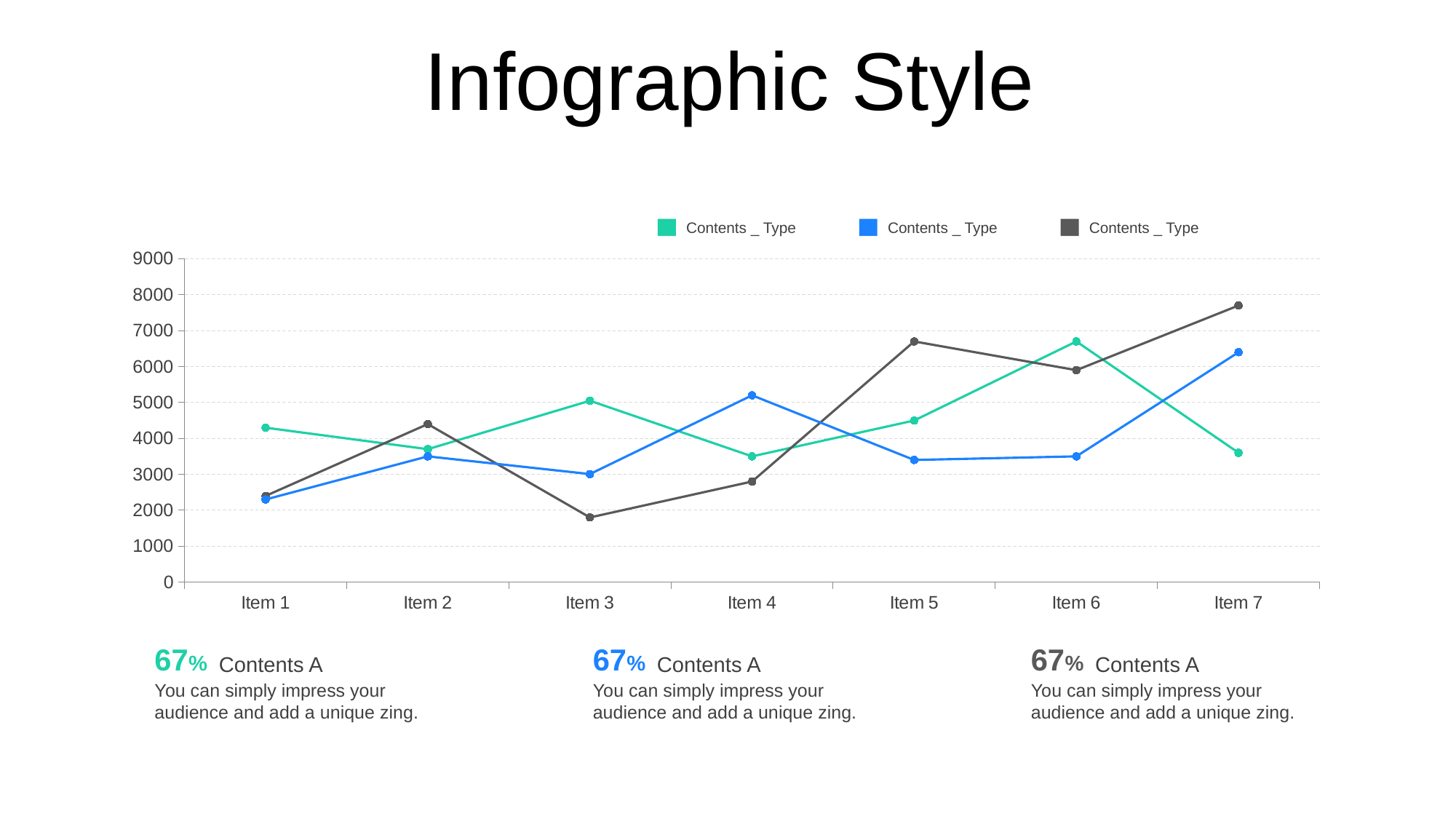
What is the highest value shown on the chart's y axis? 9000 What type of chart is shown on the slide? Line chart At which item does the dark grey line reach its lowest value? Item 3 At which item does the green line reach its highest value? Item 6 How many series does the chart's legend list? 3 Is the value of the blue line at Item 7 greater or less than 6000? greater Does the blue line rise or fall from Item 5 to Item 7? Rises How many items are plotted along the x axis of the chart? 7 At which item does the dark grey line reach its highest value? Item 7 Is the value of the green line at Item 6 greater or less than 6000? greater Is the value of the dark grey line at Item 3 greater or less than 2000? less At Item 4, which line has the larger value, the blue line or the green line? Blue line